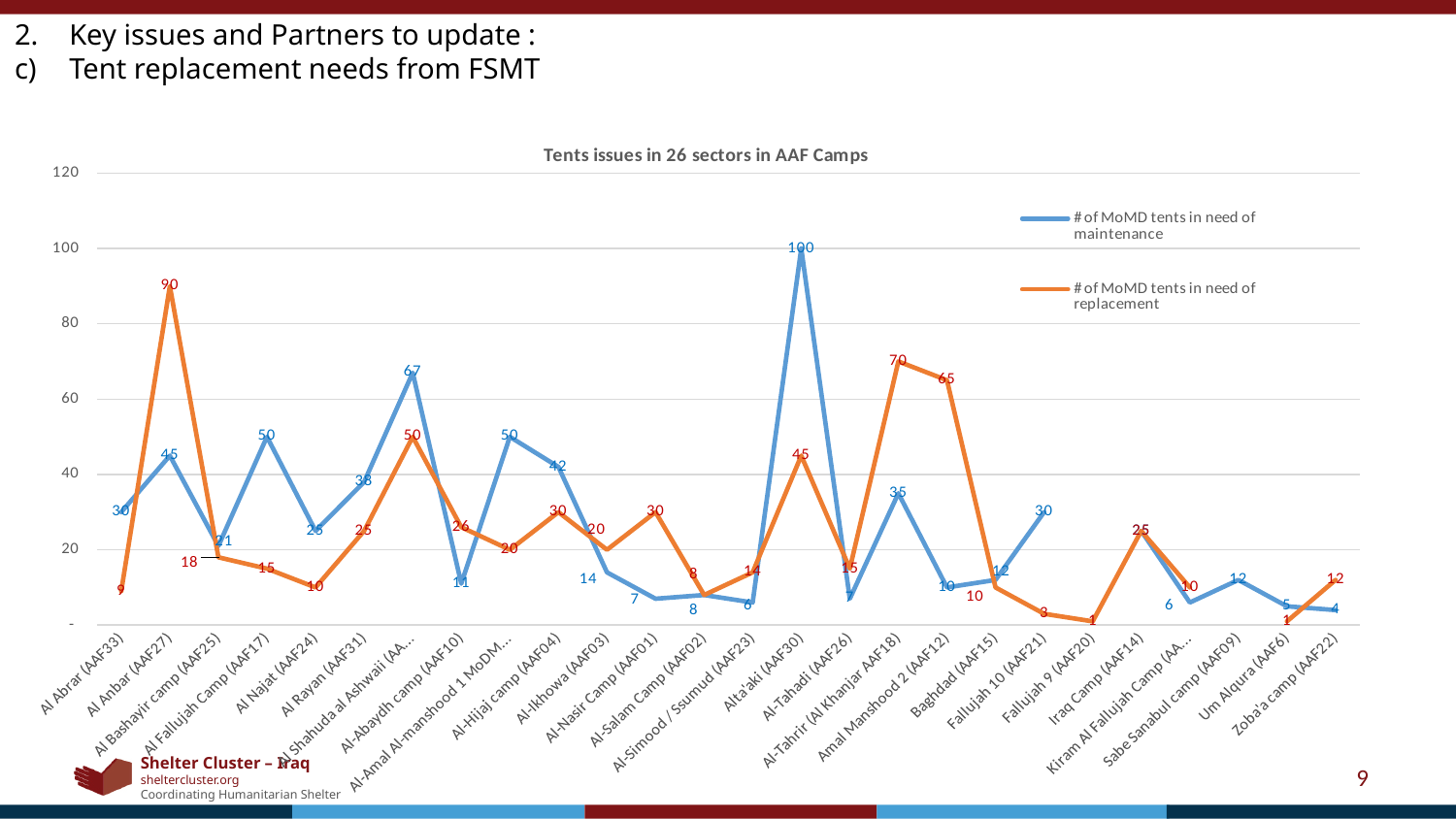
How many MoMD tents are in need of maintenance in Al Shahuda al Ashwaii? 67 What is the title of the chart? Tents issues in 26 sectors in AAF Camps Is the number of MoMD tents in need of replacement in Al-Tahrir (Al Khanjar AAF18) greater or less than 60? greater In Alta'aki (AAF30), what is the difference between the number of tents in need of maintenance and the number in need of replacement? 55 In Al Anbar (AAF27), which is larger: the number of tents in need of maintenance or the number in need of replacement? replacement How many MoMD tents are in need of replacement in Al-Tahrir (Al Khanjar AAF18)? 70 Which sector has the highest number of MoMD tents in need of replacement? Al Anbar (AAF27) Which sector has the highest number of MoMD tents in need of maintenance? Alta'aki (AAF30) How many series does the legend list? 2 What kind of chart is shown on the slide? line chart How many MoMD tents are in need of replacement in Amal Manshood 2 (AAF12)? 65 How many sectors (categories) are plotted along the x axis? 26